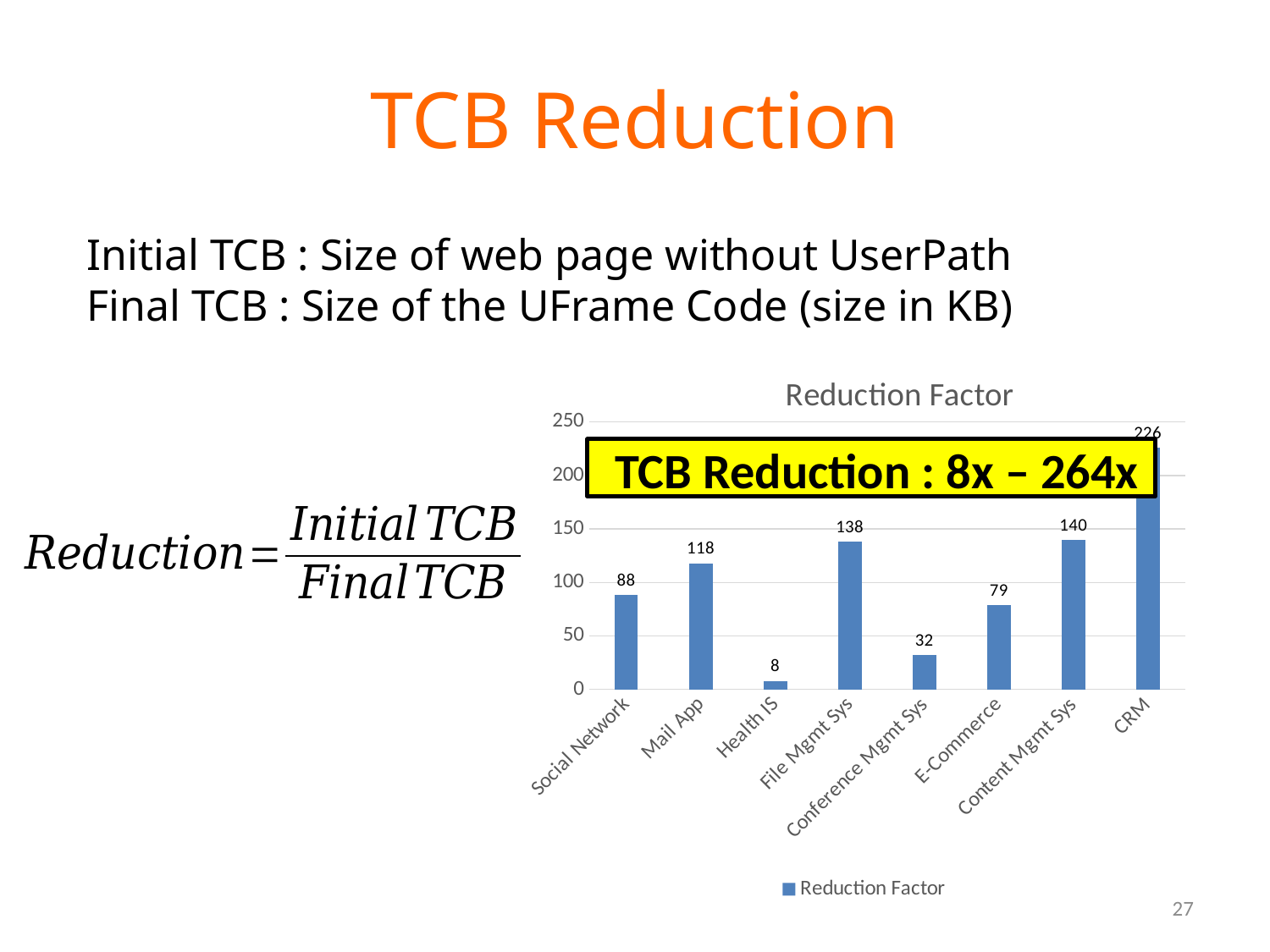
Which has a larger Reduction Factor, Content Mgmt Sys or Mail App? Content Mgmt Sys What is the Reduction Factor for Mail App? 118 How many categories are shown on the x axis of the chart? 8 Which category has the highest Reduction Factor? CRM What is the Reduction Factor for Conference Mgmt Sys? 32 What is the title of the chart? Reduction Factor What is the difference between the Reduction Factor for File Mgmt Sys and Social Network? 50 Is the Reduction Factor for Social Network greater or less than 100? less What kind of chart is shown on the slide? bar chart Which category has the lowest Reduction Factor? Health IS How many series does the chart legend list? 1 What is the Reduction Factor for E-Commerce? 79